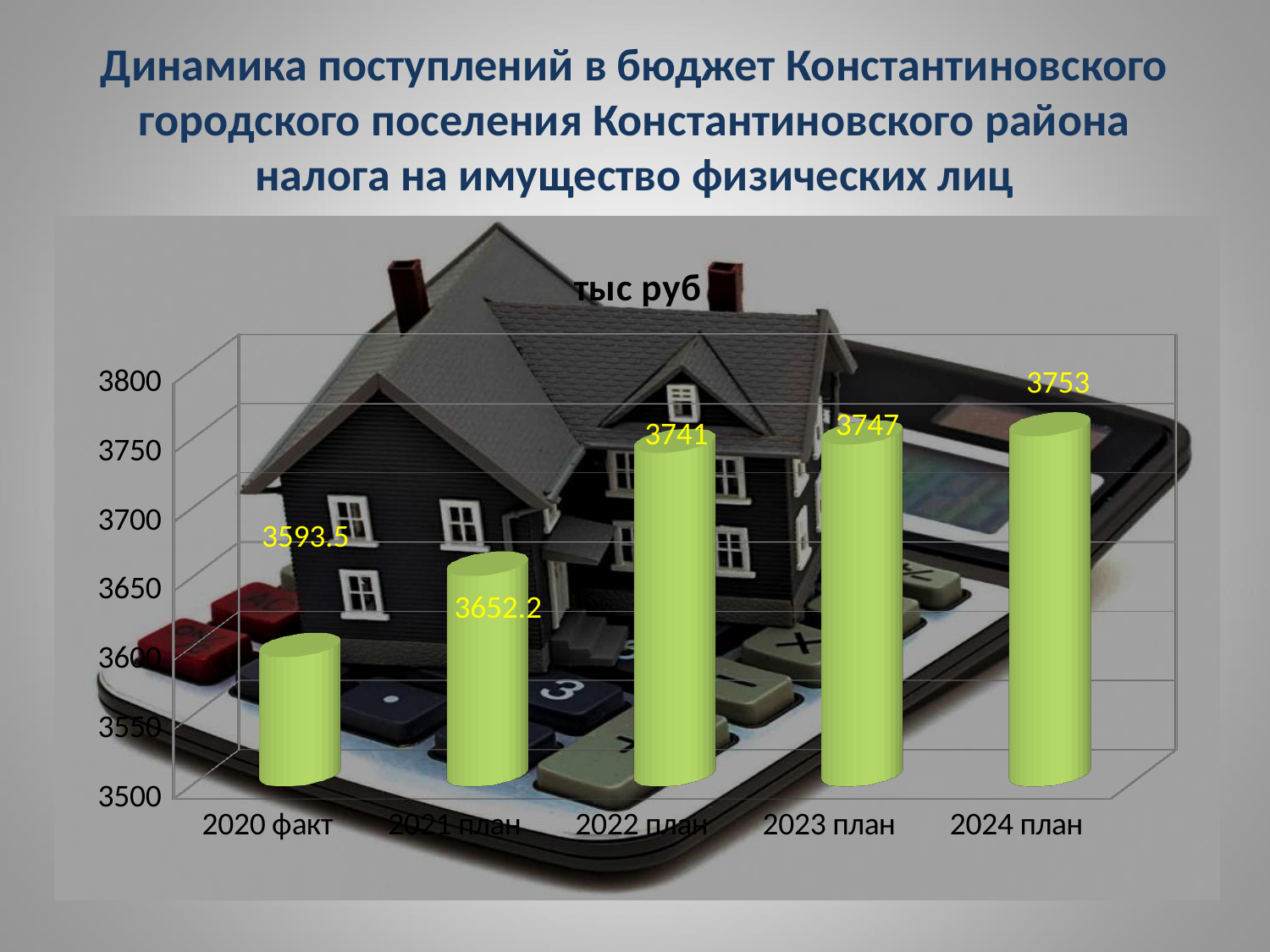
What kind of chart is shown on the slide? Bar chart Do the values rise or fall from 2020 факт to 2024 план? Rise Which category has the highest value? 2024 план What is the value for 2020 факт? 3593.5 Which category has the lowest value? 2020 факт What is the difference between the values for 2021 план and 2020 факт? 58.7 What is the value for 2021 план? 3652.2 What is the value for 2022 план? 3741 How many categories are shown on the x axis? 5 Which is larger, the value for 2022 план or the value for 2021 план? 2022 план What is the value for 2024 план? 3753 What is the difference between the values for 2024 план and 2023 план? 6